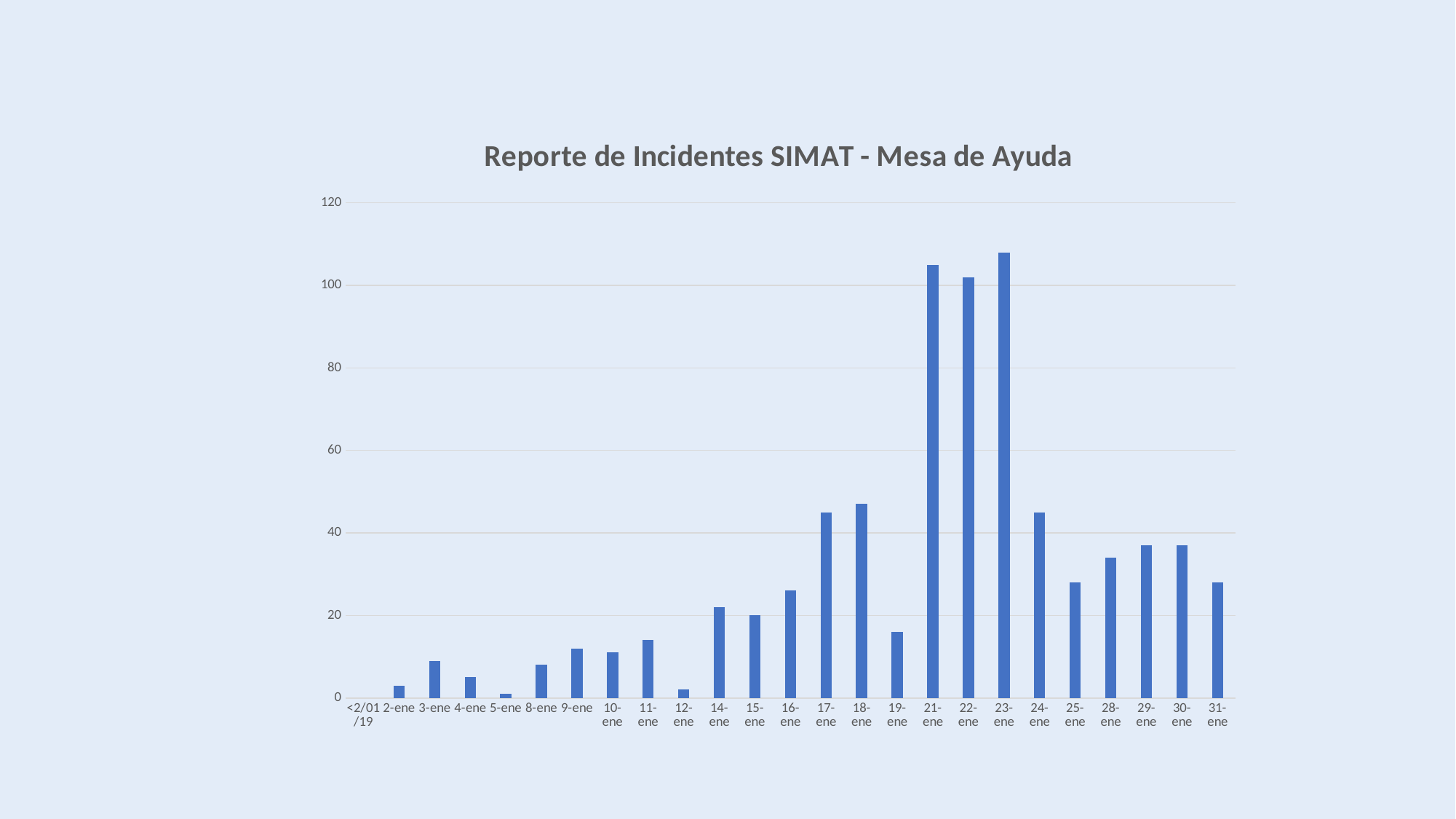
Which has the larger value, 22-ene or 24-ene? 22-ene Do the values rise or fall from 23-ene to 25-ene? fall Is the value for 29-ene greater or less than 40? less Is the value for 19-ene greater or less than 20? less Is the value for 17-ene greater or less than 40? greater Which has the larger value, 18-ene or 19-ene? 18-ene What kind of chart is shown on the slide? bar chart How many categories are shown on the x axis of the chart? 25 What is the title of the chart? Reporte de Incidentes SIMAT - Mesa de Ayuda